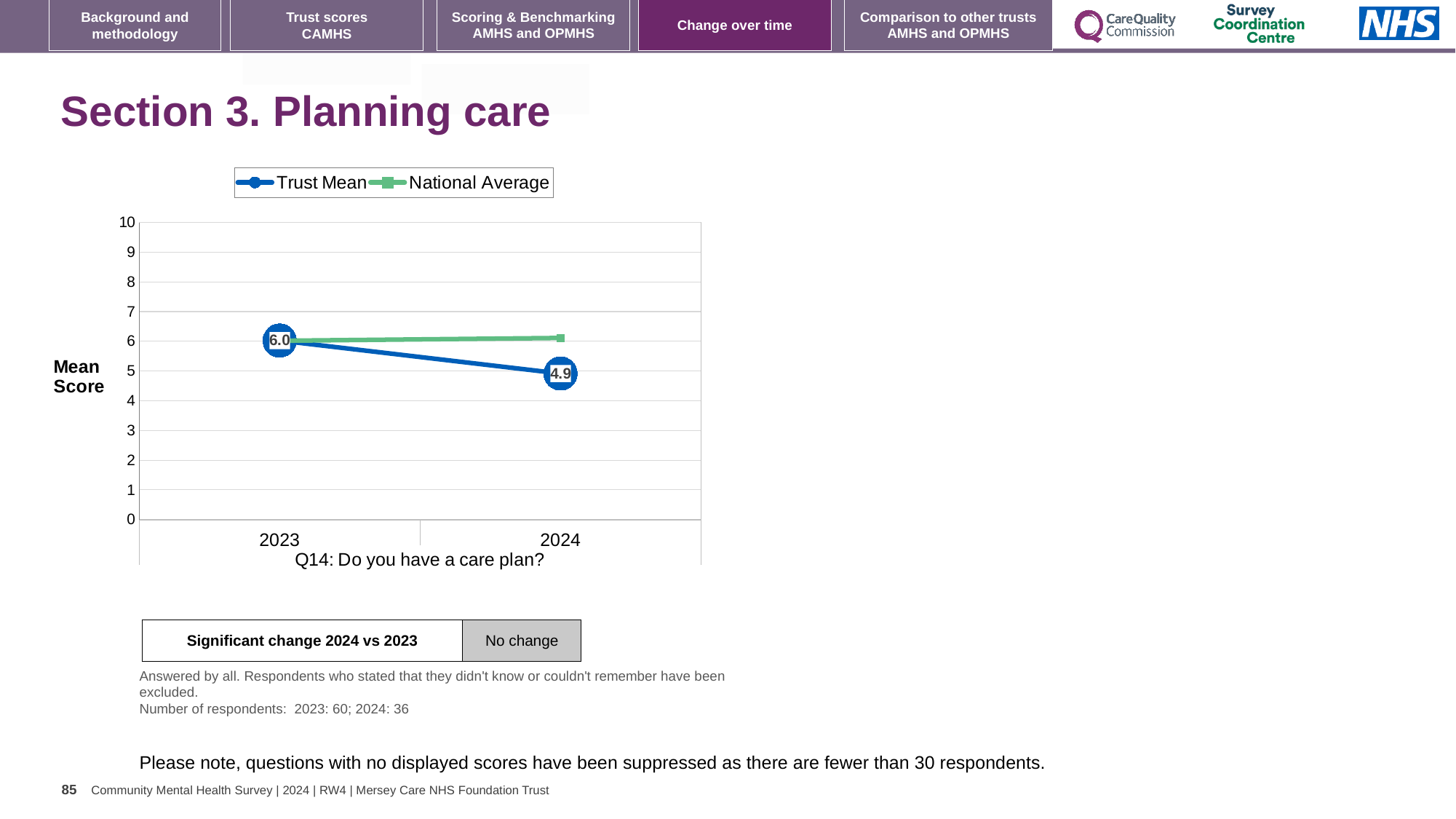
What kind of chart is shown on the slide? line chart What is the Trust Mean score for 2023? 6.0 By how much did the Trust Mean score change from 2023 to 2024? 1.1 Is the National Average value for 2024 greater or less than 5? greater Is the National Average value for 2023 greater or less than 7? less How many years are shown on the x axis of the chart? 2 How many series does the chart legend list? 2 In 2024, which is larger: the Trust Mean or the National Average? National Average What is the Trust Mean score for 2024? 4.9 In which year is the Trust Mean score higher? 2023 Does the Trust Mean rise or fall from 2023 to 2024? fall What is the label on the y axis of the chart? Mean Score